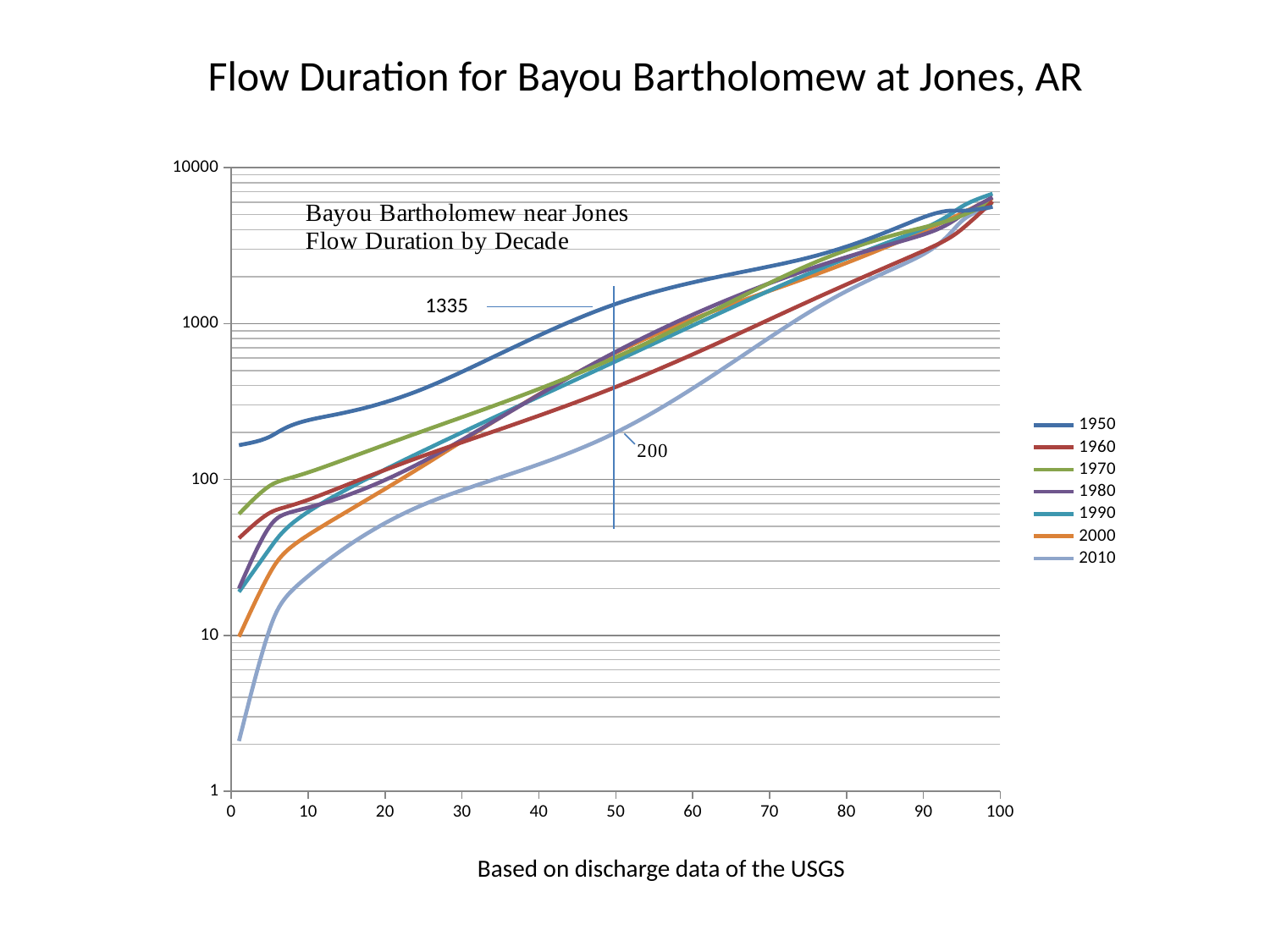
What is the difference between the annotated 1950 value (1335) and the annotated 2010 value (200) at 50 on the x axis? 1135 Do the values of the series rise or fall as the x axis increases from 0 to 100? rise What kind of chart is shown on the slide? line chart Is the value for the 2010 series at 1 on the x axis greater or less than 10? less At 50 on the x axis, which series has the larger value, 1950 or 2010? 1950 What is the annotated value for the 2010 series at 50 on the x axis? 200 What is the title of the slide's chart? Flow Duration for Bayou Bartholomew at Jones, AR Which series has the lowest value at 50 on the x axis? 2010 How many series does the legend list? 7 According to the note below the chart, what is the data based on? Based on discharge data of the USGS What is the annotated value for the 1950 series at 50 on the x axis? 1335 Which series has the highest value at 50 on the x axis? 1950